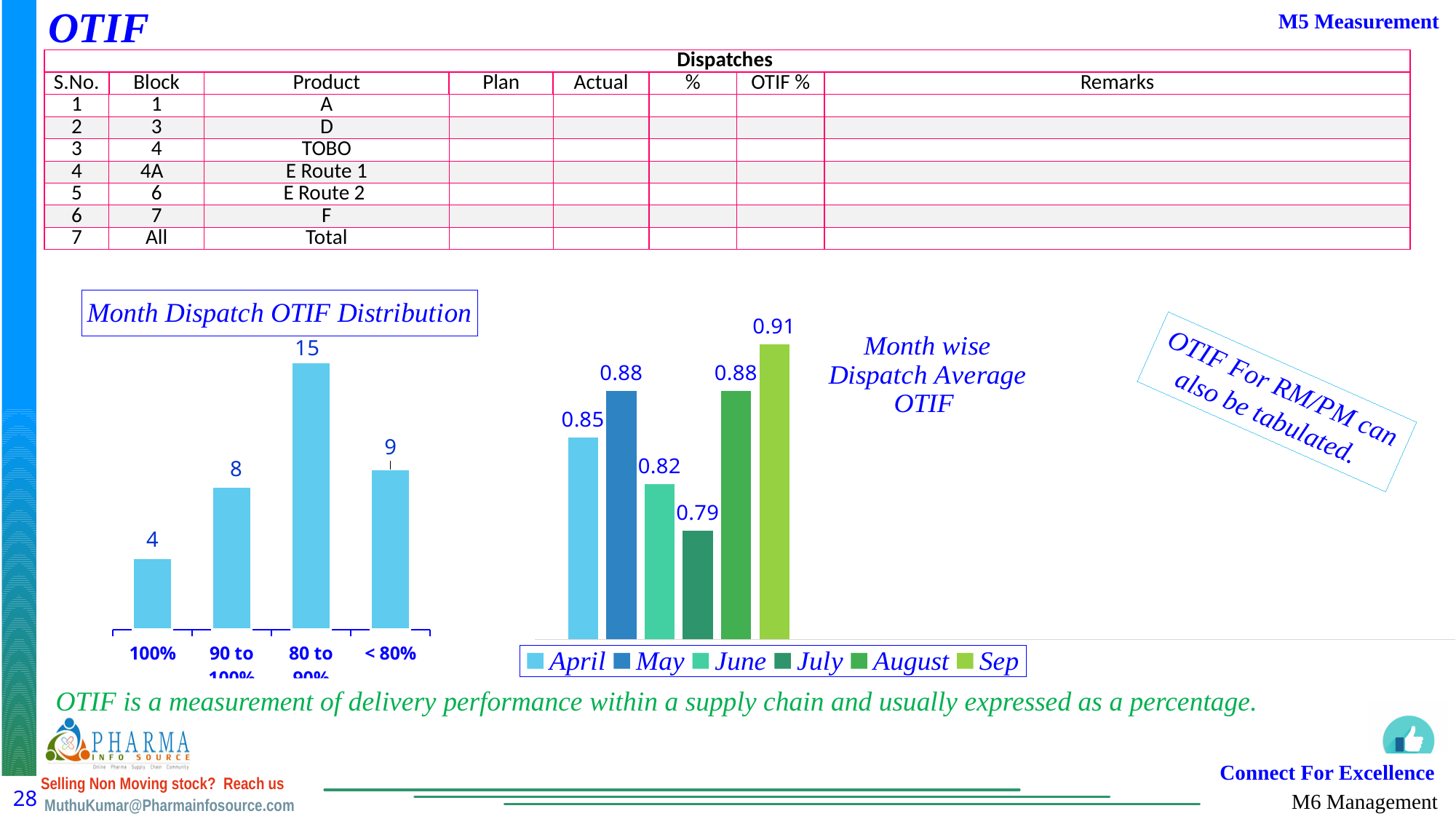
In the Month wise Dispatch Average OTIF chart, what is the value for July? 0.79 In the Month Dispatch OTIF Distribution chart, which category has the highest value? 80 to 90% In the Month Dispatch OTIF Distribution chart, which category has the lowest value? 100% In the Month wise Dispatch Average OTIF chart, which month has the lowest value? July In the Month Dispatch OTIF Distribution chart, what is the value for the 80 to 90% category? 15 In the Month wise Dispatch Average OTIF chart, what is the difference between the Sep value and the July value? 0.12 How many entries does the legend of the Month wise Dispatch Average OTIF chart list? 6 How many categories are shown in the Month Dispatch OTIF Distribution chart? 4 In the Month Dispatch OTIF Distribution chart, what is the difference between the < 80% value and the 90 to 100% value? 1 In the Month wise Dispatch Average OTIF chart, which is larger, the value for April or the value for June? April In the Month wise Dispatch Average OTIF chart, what is the value for Sep? 0.91 In the Month Dispatch OTIF Distribution chart, what is the value for the 100% category? 4